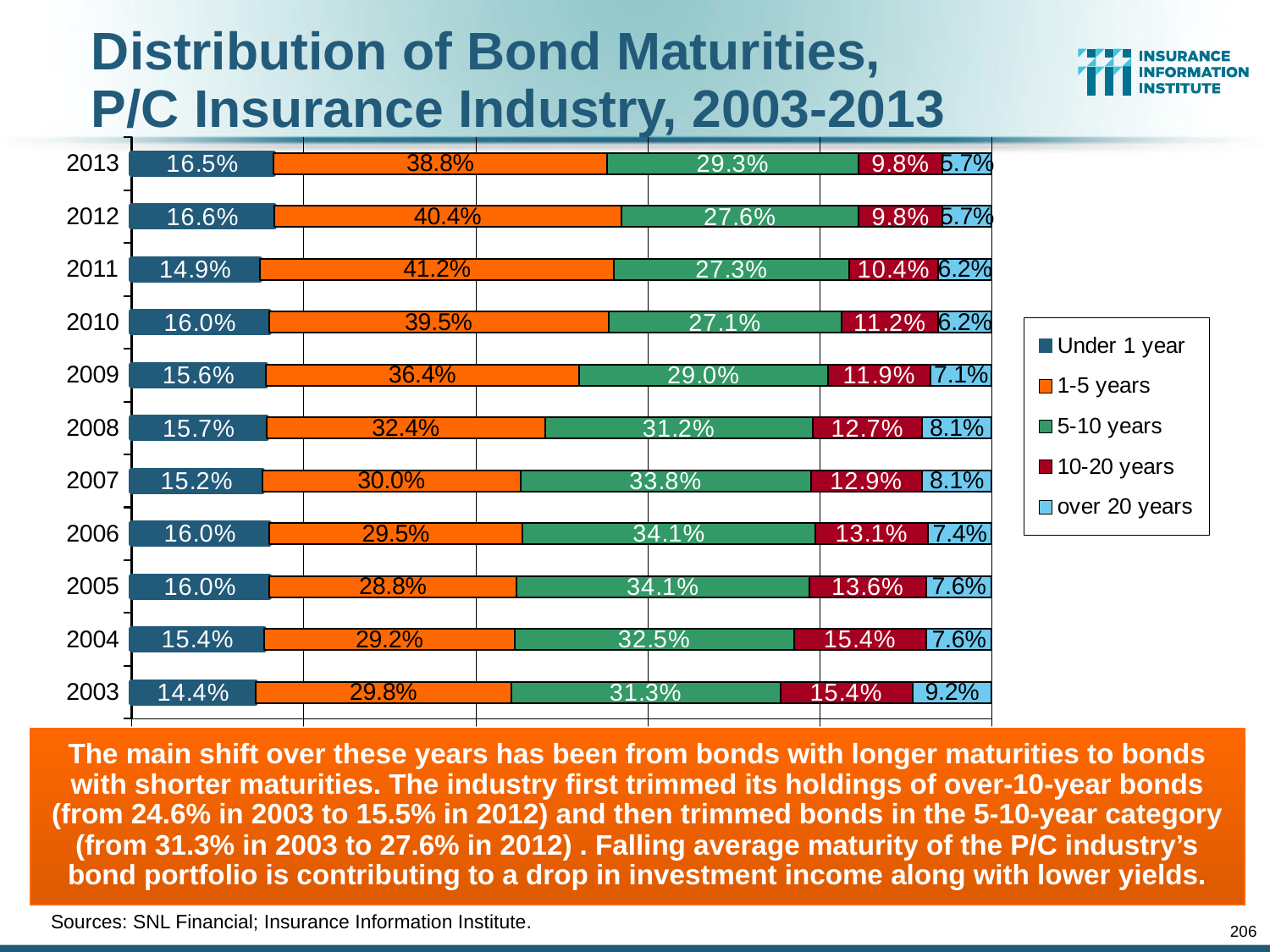
What is the value for 5-10 years in 2007? 33.8% Which year has the lowest value for Under 1 year? 2003 How many series does the legend list? 5 What kind of chart is shown on the slide? Stacked bar chart Does the 10-20 years value rise or fall from 2003 to 2013? Fall Which year has the highest value for 1-5 years? 2011 How many years are shown on the chart? 11 What is the value for over 20 years in 2003? 9.2% What is the value for 10-20 years in 2003? 15.4% What is the value for 1-5 years in 2011? 41.2% What is the difference between the 1-5 years value in 2013 and in 2003? 9.0% Which is larger, the 5-10 years value in 2006 or in 2013? 2006